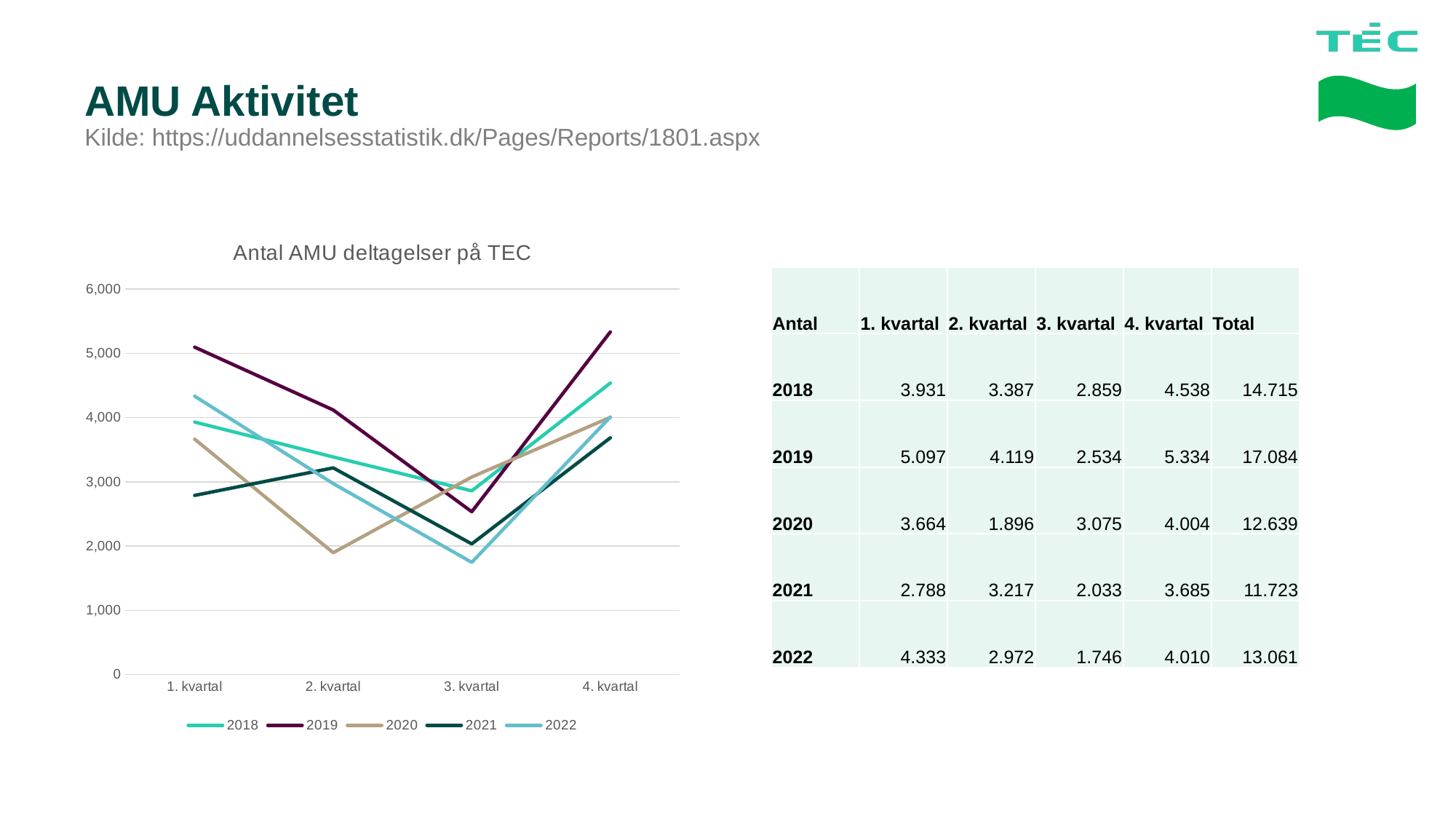
Which year has the highest value in 1. kvartal? 2019 Is the value for 2021 in 1. kvartal greater or less than 3,000? less What is the difference between the 2019 value in 4. kvartal and the 2019 value in 3. kvartal? 2.800 In 2. kvartal, which is larger: the value for 2018 or the value for 2020? 2018 Which year has the lowest value in 3. kvartal? 2022 How many categories are shown on the x axis of the chart? 4 What is the title of the chart? Antal AMU deltagelser på TEC What is the value for 2019 in 4. kvartal? 5.334 How many series does the legend of the chart list? 5 Does the 2020 line rise or fall from 1. kvartal to 2. kvartal? fall What kind of chart is shown on the slide? line chart What is the value for 2022 in 3. kvartal? 1.746